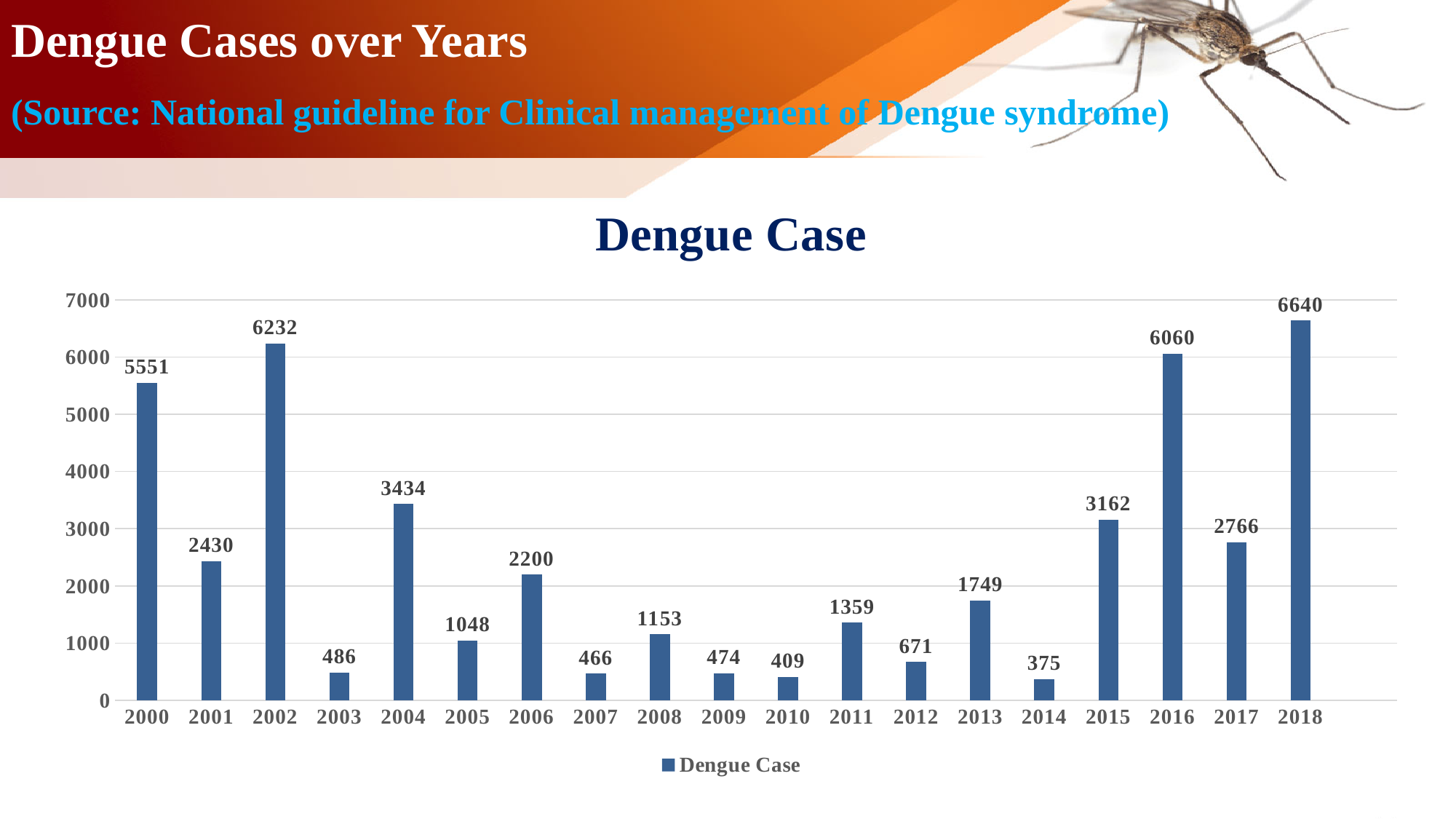
What is the number of dengue cases in 2016? 6060 Which year has the highest number of dengue cases? 2018 How many years are shown on the x axis of the chart? 19 What is the difference in dengue cases between 2018 and 2017? 3874 Which year has the lowest number of dengue cases? 2014 What is the number of dengue cases in 2002? 6232 How many series does the legend list? 1 What is the number of dengue cases in 2014? 375 Is the value for 2013 greater or less than 2000? less What is the difference in dengue cases between 2002 and 2000? 681 What kind of chart is shown on the slide? Bar chart Which year had more dengue cases, 2004 or 2015? 2004